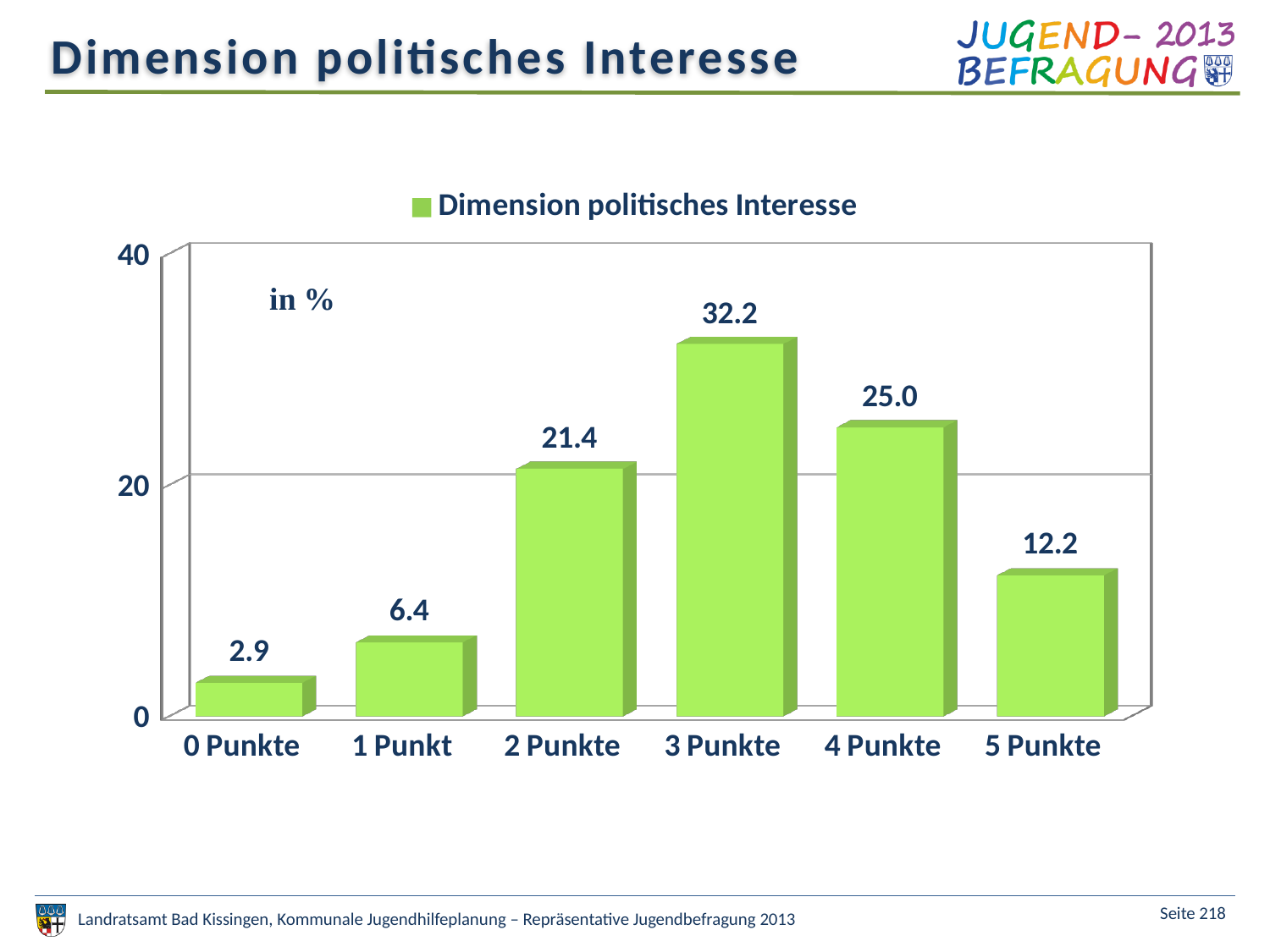
Is the value for 4 Punkte greater or less than 20? greater How many series does the legend list? 1 Which category has the lowest value? 0 Punkte How many categories are shown on the x axis? 6 What is the legend entry of the chart? Dimension politisches Interesse What is the value for 0 Punkte? 2.9 What is the difference between the values for 3 Punkte and 4 Punkte? 7.2 What is the value for 5 Punkte? 12.2 What is the value for 3 Punkte? 32.2 What kind of chart is shown? bar chart Which category has the highest value? 3 Punkte Which is larger, the value for 2 Punkte or the value for 5 Punkte? 2 Punkte